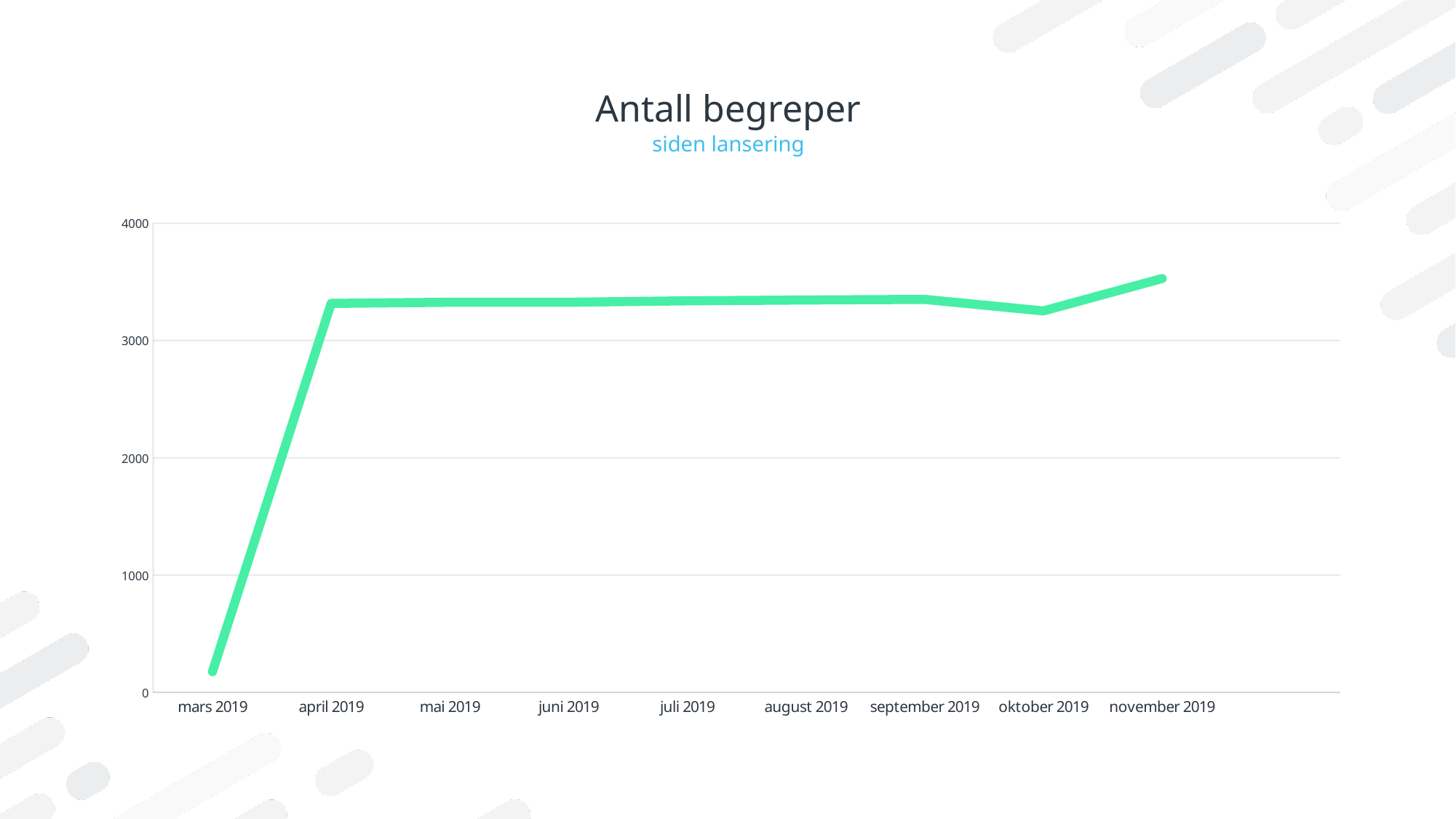
What subtitle appears below the chart title? siden lansering Is the value for oktober 2019 greater or less than 3000? greater How many months are plotted along the x axis? 9 Does the line rise or fall between mars 2019 and april 2019? rise Is the value for april 2019 greater or less than 3000? greater What kind of chart is shown on the slide? line chart What is the title of the chart? Antall begreper Which is larger, the value for mars 2019 or the value for april 2019? april 2019 Which month has the highest value? november 2019 Is the value for mars 2019 greater or less than 1000? less Which month has the lowest value? mars 2019